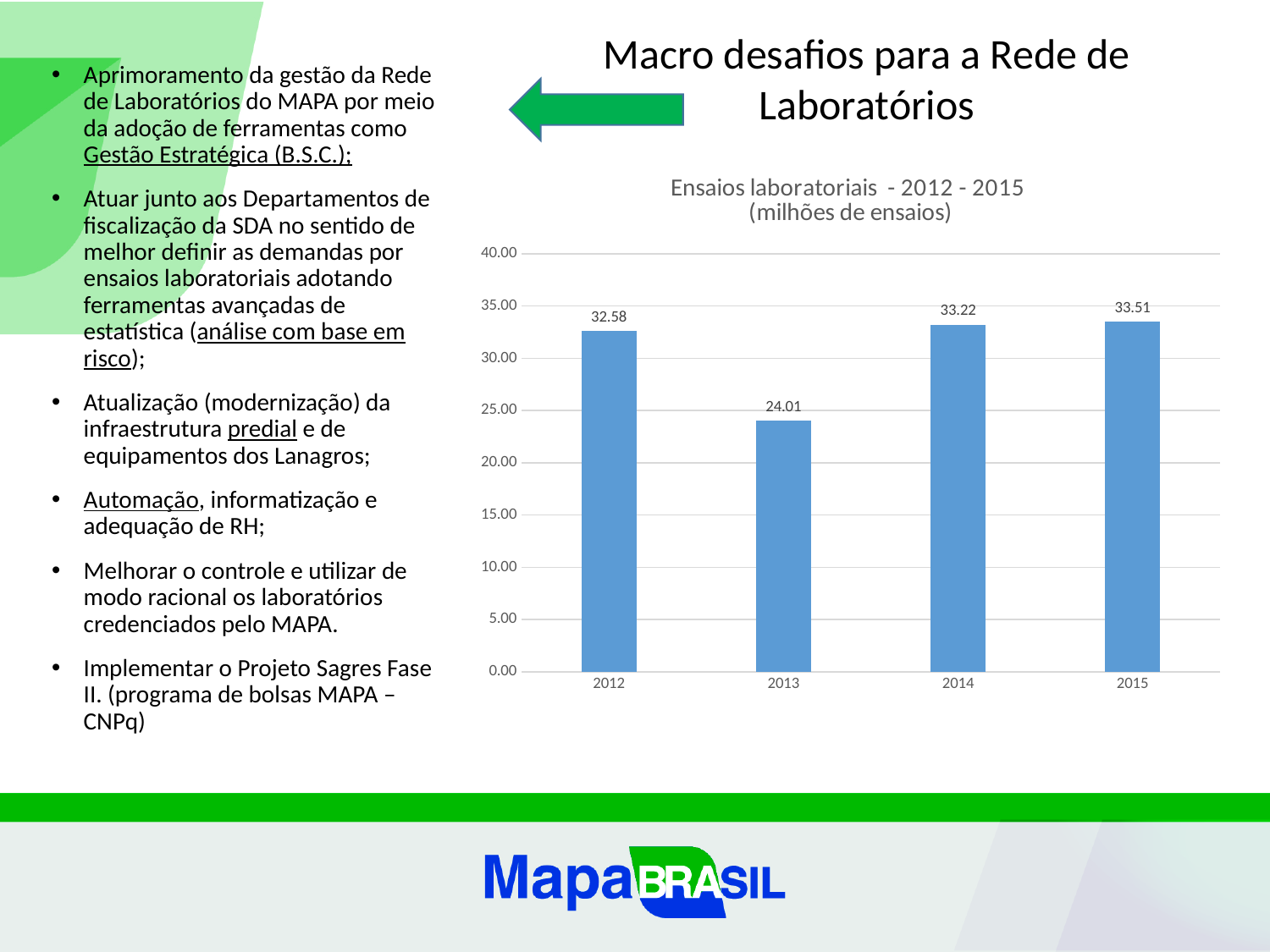
What is the value for 2015? 33.51 Which is larger, the value for 2012 or the value for 2014? 2014 What is the value for 2013? 24.01 What is the value for 2014? 33.22 Is the value for 2013 greater or less than 25.00? less What is the value for 2012? 32.58 What is the difference between the values for 2012 and 2013? 8.57 What kind of chart is shown on the slide? bar chart Which year has the lowest value? 2013 Which year has the highest value? 2015 What is the title of the chart? Ensaios laboratoriais - 2012 - 2015 (milhões de ensaios) How many years are shown on the x axis? 4